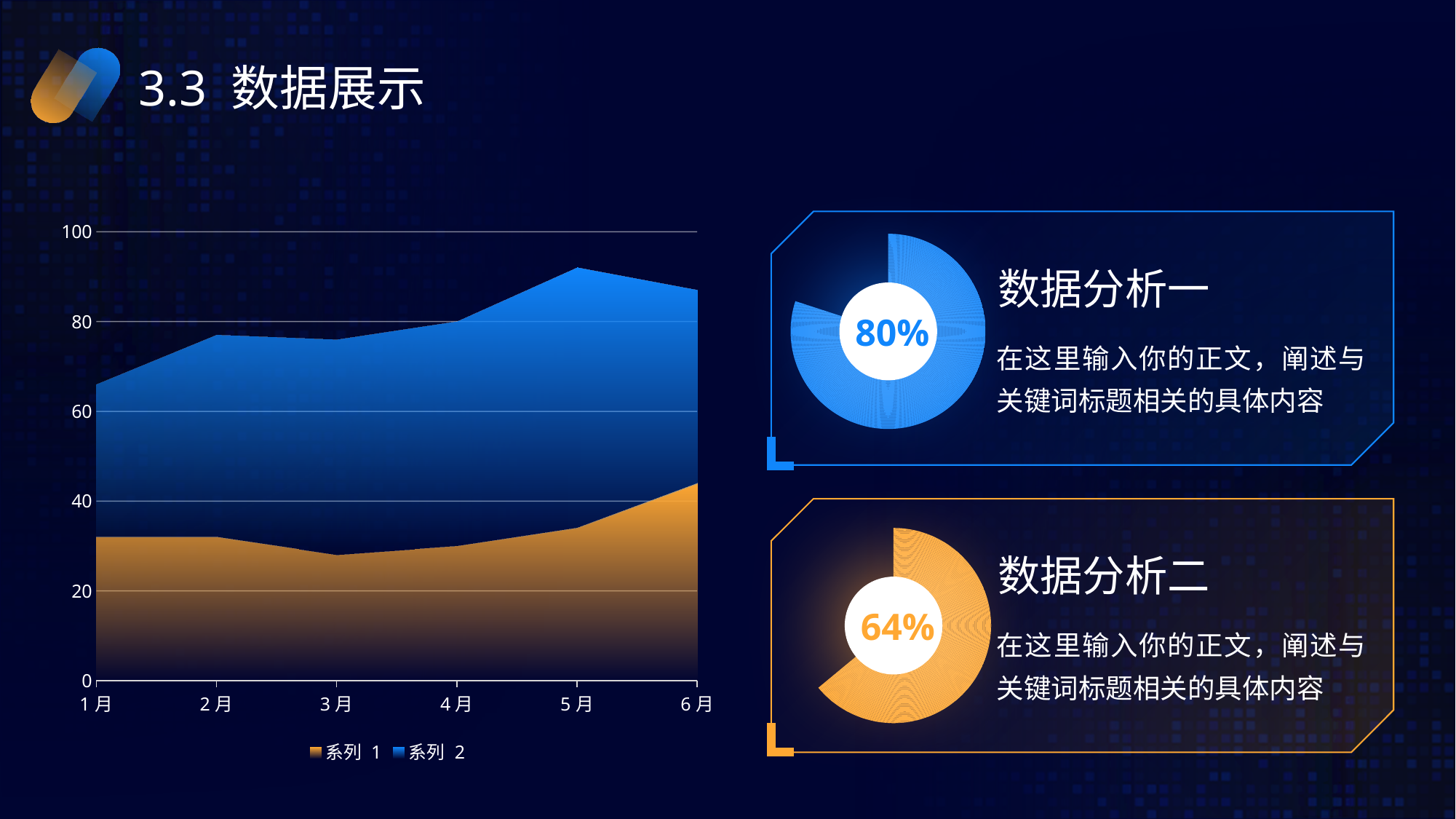
In the area chart on the left, which month has the highest value for 系列 1? 6月 In the area chart on the left, how many series does the legend list? 2 In the area chart on the left, is the top of the stacked area in 1月 greater or less than 80? less What percentage is shown in the donut chart labelled 数据分析二? 64% In the area chart on the left, does the value for 系列 1 rise or fall from 4月 to 6月? rise In the area chart on the left, is the top of the stacked area in 5月 greater or less than 80? greater In the area chart on the left, how many months are shown on the x axis? 6 What kind of chart is the chart on the left side of the slide? area chart In the area chart on the left, is the value for 系列 1 in 3月 greater or less than 40? less What percentage is shown in the donut chart labelled 数据分析一? 80% In the area chart on the left, what are the names of the two series in the legend? 系列 1 and 系列 2